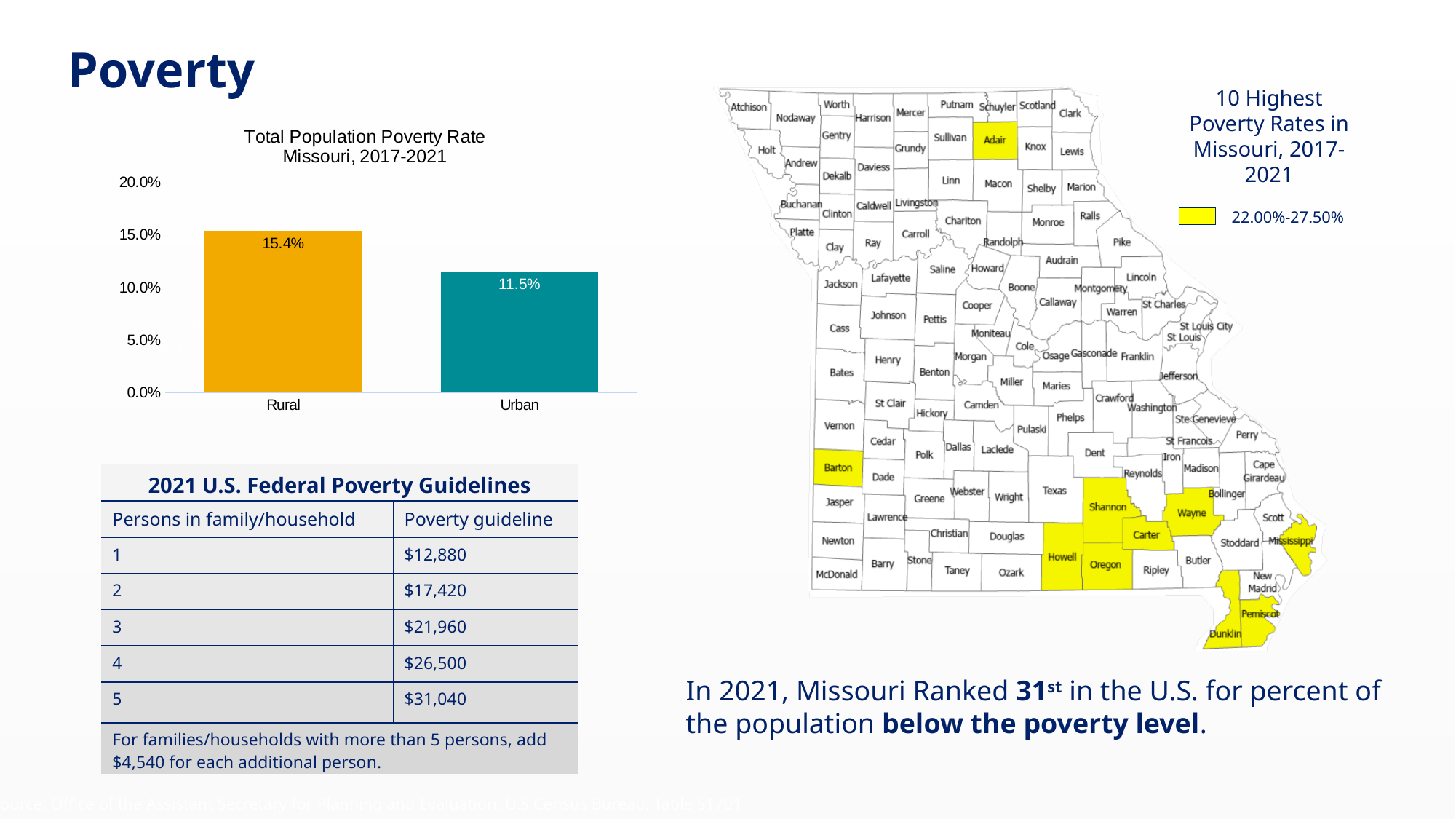
How many categories are shown in the Total Population Poverty Rate chart? 2 In the Total Population Poverty Rate chart, is the value for Urban greater or less than 15.0%? less In the Total Population Poverty Rate chart, is the value for Rural greater or less than 15.0%? greater What is the poverty rate for Urban in the Total Population Poverty Rate chart? 11.5% Which category has the highest poverty rate in the Total Population Poverty Rate chart? Rural What kind of chart is the Total Population Poverty Rate chart? bar chart What is the difference between the Rural and Urban poverty rates in the Total Population Poverty Rate chart? 3.9% Which category has the lowest poverty rate in the Total Population Poverty Rate chart? Urban What is the highest value shown on the y axis of the Total Population Poverty Rate chart? 20.0% In the Total Population Poverty Rate chart, is the Rural or Urban poverty rate larger? Rural What is the poverty rate for Rural in the Total Population Poverty Rate chart? 15.4% What is the title of the bar chart on the left of the slide? Total Population Poverty Rate Missouri, 2017-2021